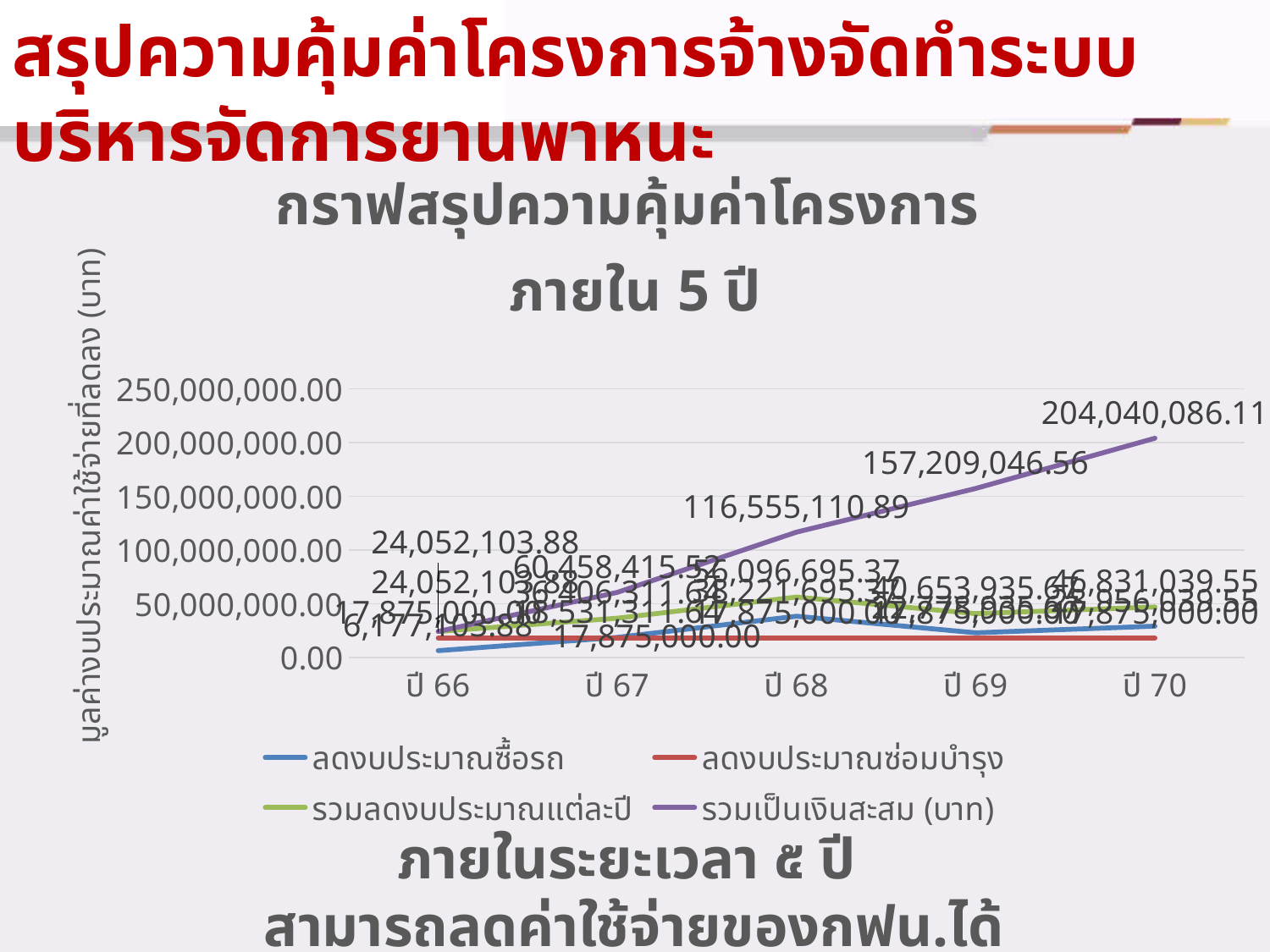
What is the value of ลดงบประมาณซ่อมบำรุง for ปี 67? 17,875,000.00 How many series does the chart legend list? 4 What is the difference between รวมเป็นเงินสะสม (บาท) for ปี 70 and ปี 69? 46,831,039.55 How many years (categories) are shown on the x axis of the chart? 5 What is the value of รวมเป็นเงินสะสม (บาท) for ปี 69? 157,209,046.56 What is the value of รวมเป็นเงินสะสม (บาท) for ปี 68? 116,555,110.89 What is the title of the chart? กราฟสรุปความคุ้มค่าโครงการ ภายใน 5 ปี In which year is รวมเป็นเงินสะสม (บาท) highest? ปี 70 Does the รวมเป็นเงินสะสม (บาท) series rise or fall from ปี 66 to ปี 70? rise What kind of chart is shown on the slide? line chart What is the value of รวมเป็นเงินสะสม (บาท) for ปี 70? 204,040,086.11 Is the value of รวมเป็นเงินสะสม (บาท) for ปี 68 greater or less than 100,000,000.00? greater